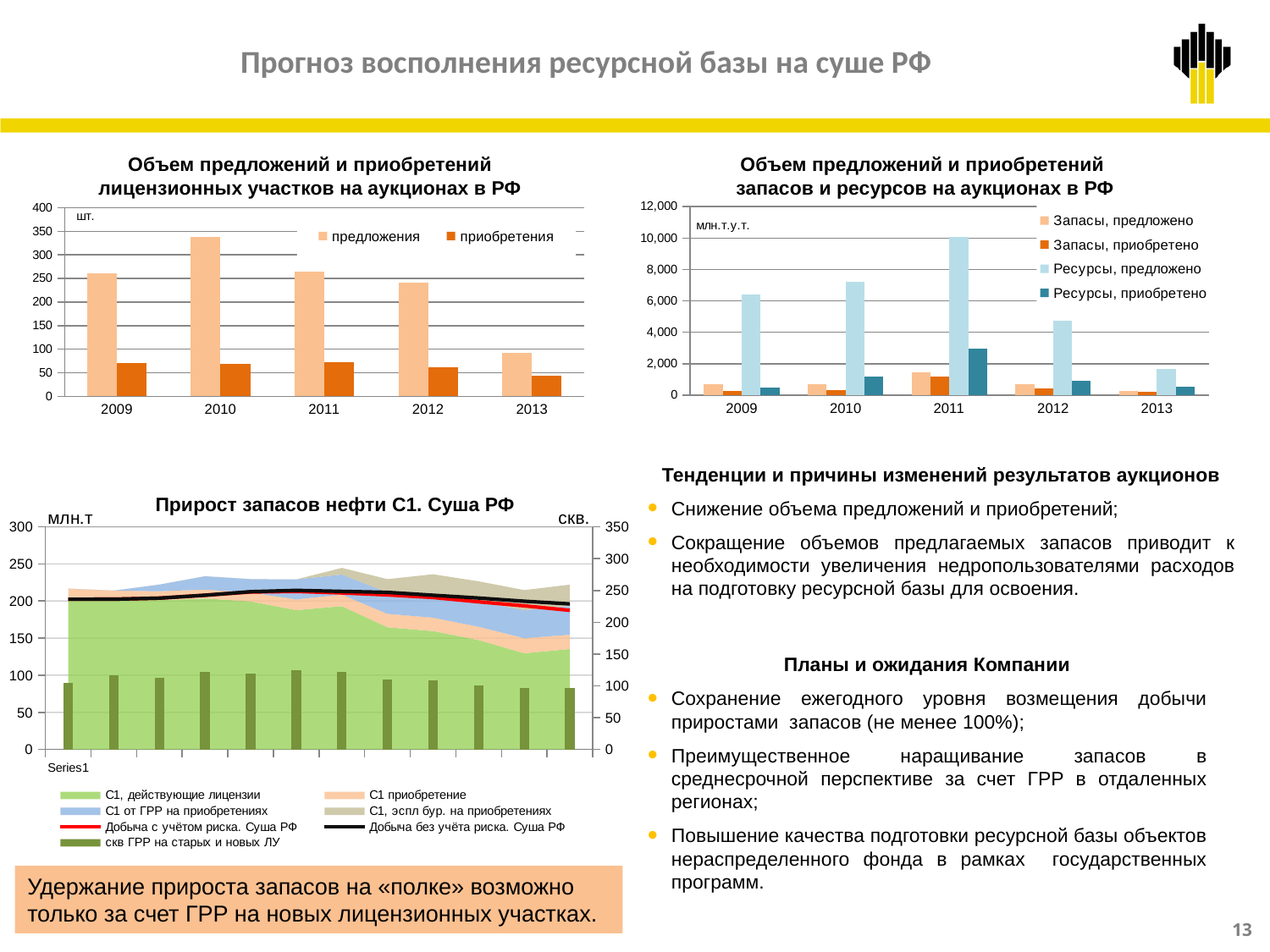
In the chart 'Объем предложений и приобретений запасов и ресурсов на аукционах в РФ', is the value for 'Ресурсы, предложено' in 2011 greater or less than 8,000? greater In the chart 'Объем предложений и приобретений лицензионных участков на аукционах в РФ', which is larger: предложения in 2009 or предложения in 2010? 2010 How many years are shown on the x axis of the chart 'Объем предложений и приобретений запасов и ресурсов на аукционах в РФ'? 5 What unit is shown on the chart 'Объем предложений и приобретений запасов и ресурсов на аукционах в РФ'? млн.т.у.т. In the chart 'Объем предложений и приобретений лицензионных участков на аукционах в РФ', is the value for предложения in 2010 greater or less than 300? greater How many series does the legend list in the chart 'Прирост запасов нефти С1. Суша РФ'? 7 In the chart 'Объем предложений и приобретений лицензионных участков на аукционах в РФ', which year has the highest value for предложения? 2010 How many series does the legend list in the chart 'Объем предложений и приобретений лицензионных участков на аукционах в РФ'? 2 In the chart 'Объем предложений и приобретений лицензионных участков на аукционах в РФ', is the value for предложения in 2013 greater or less than 100? less How many series does the legend list in the chart 'Объем предложений и приобретений запасов и ресурсов на аукционах в РФ'? 4 In the chart 'Объем предложений и приобретений запасов и ресурсов на аукционах в РФ', which year has the highest value for 'Ресурсы, предложено'? 2011 In the chart 'Объем предложений и приобретений лицензионных участков на аукционах в РФ', which year has the lowest value for предложения? 2013